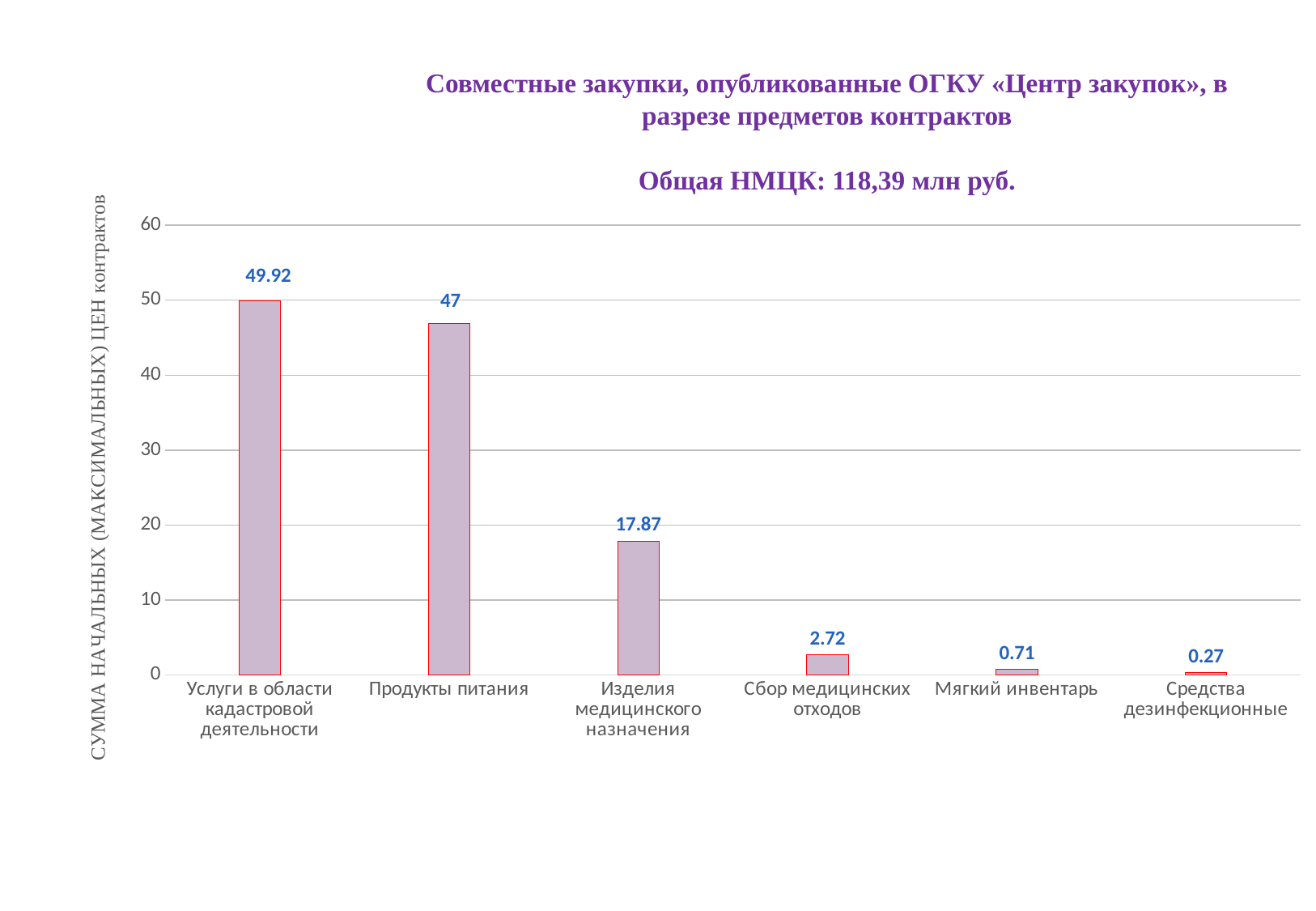
What kind of chart is shown on the slide? bar chart What total НМЦК is stated in the chart title? 118,39 млн руб. Do the values rise or fall from left to right along the x axis? fall Which is larger, the value for Сбор медицинских отходов or the value for Мягкий инвентарь? Сбор медицинских отходов What is the value for Изделия медицинского назначения? 17.87 Which category has the lowest value? Средства дезинфекционные What is the value for Мягкий инвентарь? 0.71 Is the value for Изделия медицинского назначения greater or less than 20? less What is the value for Продукты питания? 47 What is the difference between the values for Услуги в области кадастровой деятельности and Продукты питания? 2.92 Which category has the highest value? Услуги в области кадастровой деятельности How many categories are shown on the x axis? 6